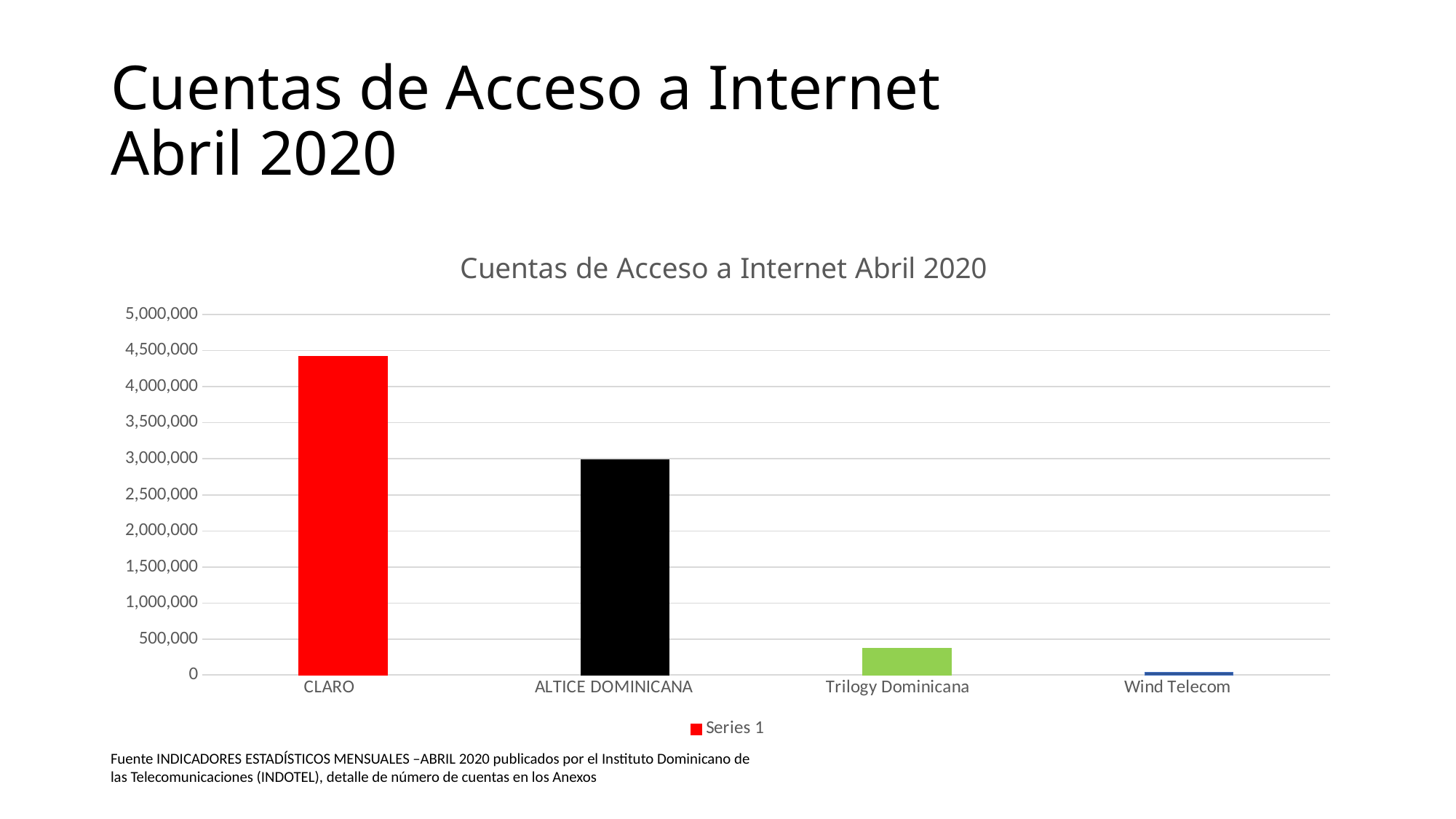
Which is larger, the value for CLARO or the value for ALTICE DOMINICANA? CLARO Which category has the highest value? CLARO How many categories are shown on the x axis of the chart? 4 What type of chart is shown on the slide? bar chart How many series does the legend list? 1 Which category has the lowest value? Wind Telecom Is the value for ALTICE DOMINICANA greater or less than 3,500,000? less Is the value for CLARO greater or less than 4,000,000? greater Is the value for Trilogy Dominicana greater or less than 500,000? less What is the title of the chart? Cuentas de Acceso a Internet Abril 2020 Which is larger, the value for Trilogy Dominicana or the value for Wind Telecom? Trilogy Dominicana What is the name of the series listed in the legend? Series 1